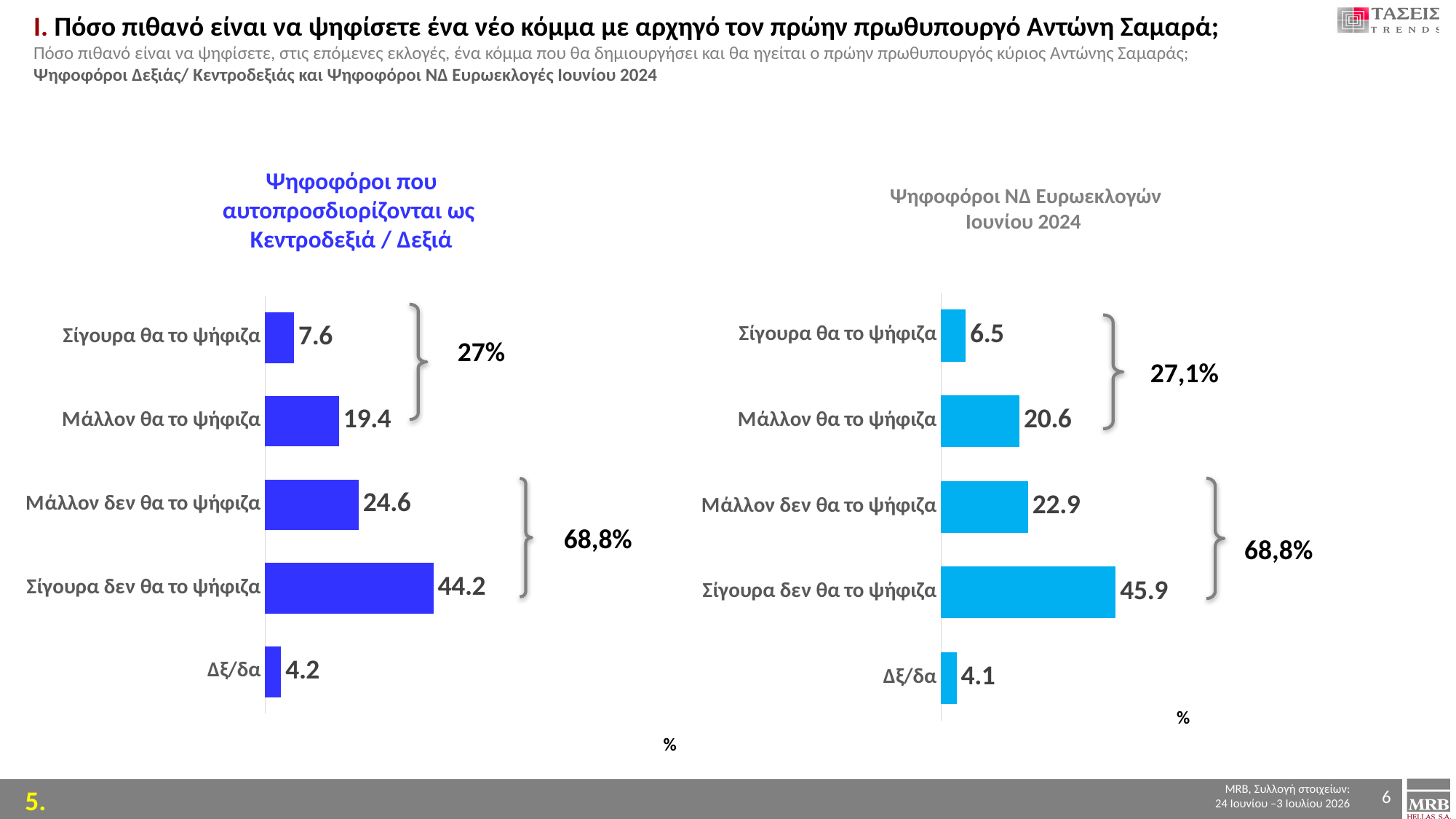
What kind of chart is used on this slide? Bar chart What is the title of the right chart? Ψηφοφόροι ΝΔ Ευρωεκλογών Ιουνίου 2024 In the right chart (Ψηφοφόροι ΝΔ Ευρωεκλογών Ιουνίου 2024), what combined percentage is shown by the bracket for the two 'δεν θα το ψήφιζα' categories? 68,8% In the right chart (Ψηφοφόροι ΝΔ Ευρωεκλογών Ιουνίου 2024), what is the value for 'Μάλλον θα το ψήφιζα'? 20.6 In the right chart (Ψηφοφόροι ΝΔ Ευρωεκλογών Ιουνίου 2024), what is the difference between 'Σίγουρα δεν θα το ψήφιζα' and 'Μάλλον δεν θα το ψήφιζα'? 23 In the left chart (Ψηφοφόροι που αυτοπροσδιορίζονται ως Κεντροδεξιά / Δεξιά), what combined percentage is shown by the bracket for the two 'θα το ψήφιζα' categories? 27% In the left chart (Ψηφοφόροι που αυτοπροσδιορίζονται ως Κεντροδεξιά / Δεξιά), which category has the highest value? Σίγουρα δεν θα το ψήφιζα In the left chart (Ψηφοφόροι που αυτοπροσδιορίζονται ως Κεντροδεξιά / Δεξιά), how many categories are plotted? 5 Which is larger: 'Σίγουρα δεν θα το ψήφιζα' in the left chart or 'Σίγουρα δεν θα το ψήφιζα' in the right chart? The right chart (45.9) In the right chart (Ψηφοφόροι ΝΔ Ευρωεκλογών Ιουνίου 2024), which category has the lowest value? Δξ/δα In the left chart (Ψηφοφόροι που αυτοπροσδιορίζονται ως Κεντροδεξιά / Δεξιά), what is the value for 'Σίγουρα θα το ψήφιζα'? 7.6 In the left chart (Ψηφοφόροι που αυτοπροσδιορίζονται ως Κεντροδεξιά / Δεξιά), what is the difference between 'Μάλλον θα το ψήφιζα' and 'Σίγουρα θα το ψήφιζα'? 11.8